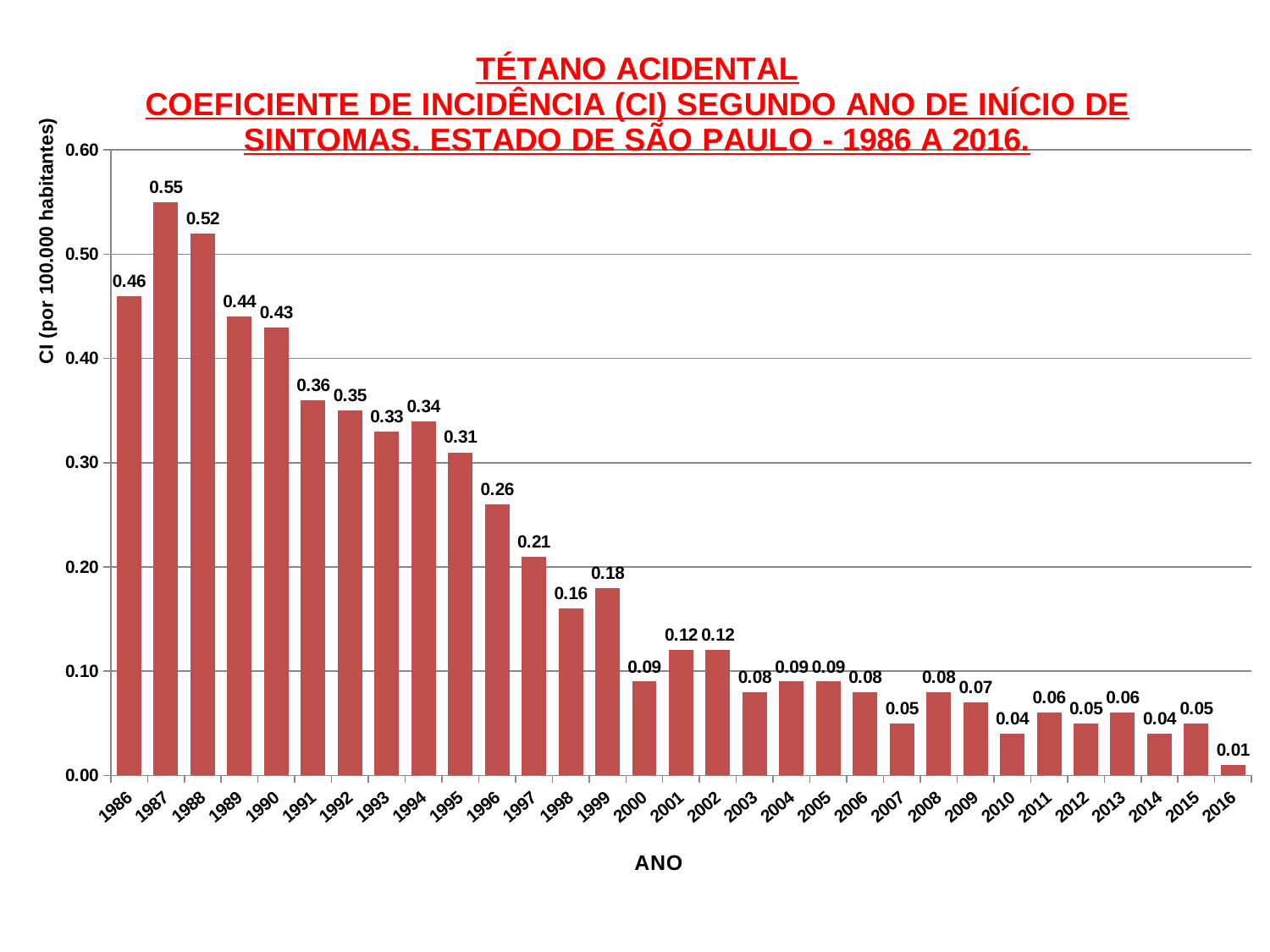
What kind of chart is shown on the slide? Bar chart Which year has the lowest incidence coefficient? 2016 What is the incidence coefficient (CI) for 2016? 0.01 Is the CI for 1995 greater or less than 0.30? greater What is the label of the y axis? CI (por 100,000 habitantes) What is the incidence coefficient (CI) for 1996? 0.26 Do the CI values generally rise or fall from 1987 to 2016? Fall What is the difference between the CI for 1986 and the CI for 1990? 0.03 Which year has a higher CI, 1998 or 1999? 1999 Which year has the highest incidence coefficient? 1987 How many years are shown on the x axis? 31 What is the incidence coefficient (CI) for 1987? 0.55